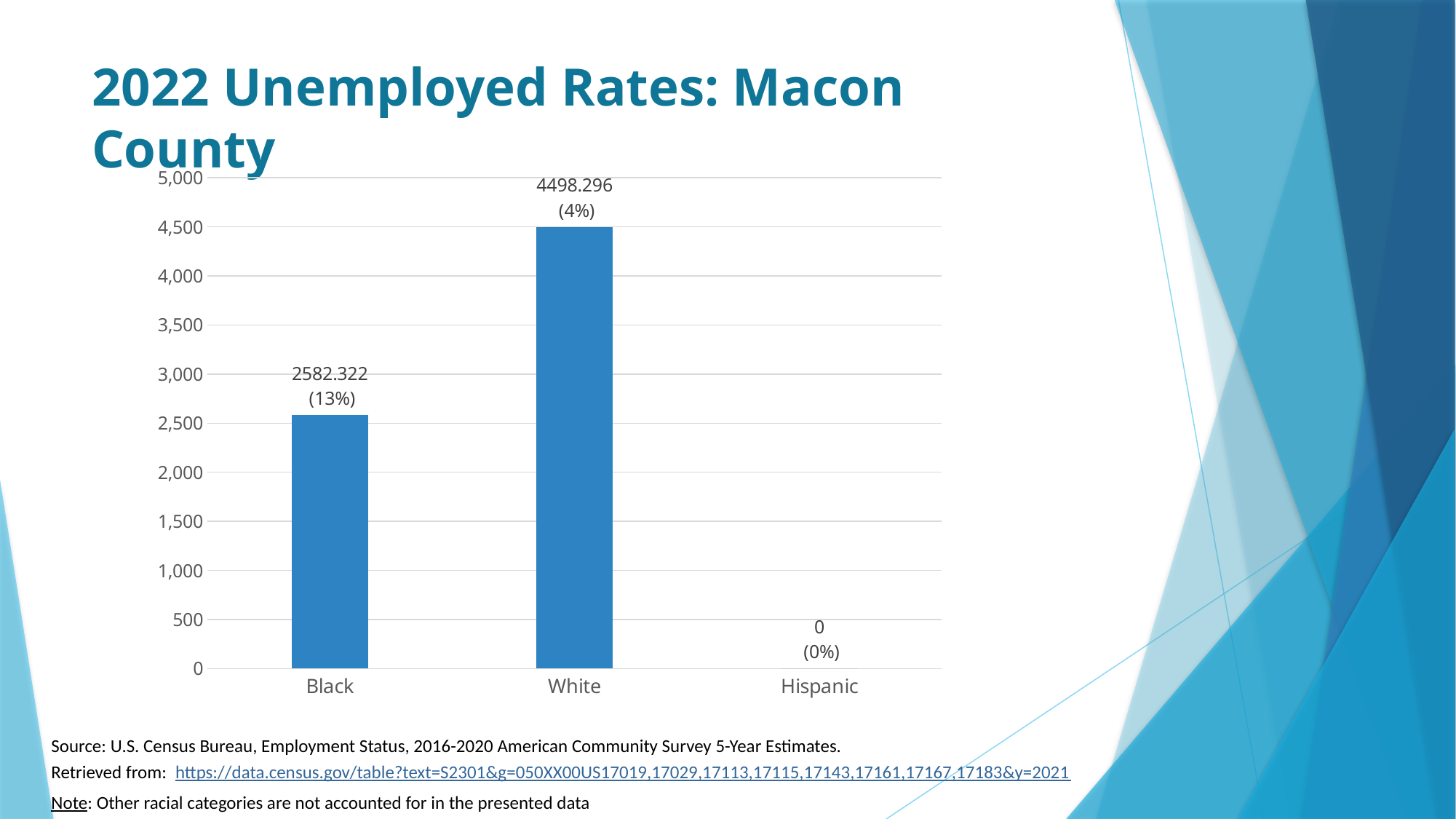
What is the value shown for White? 4498.296 Which category has the highest value? White Which is larger, the value for Black or the value for White? White Which category has the lowest value? Hispanic What is the value shown for Hispanic? 0 What percentage is shown in parentheses for Black? 13% How many categories are shown on the x axis? 3 What is the value shown for Black? 2582.322 Is the value for Black greater or less than 3,000? less What is the difference between the values for White and Black? 1915.974 What percentage is shown in parentheses for White? 4% What kind of chart is shown on the slide? bar chart